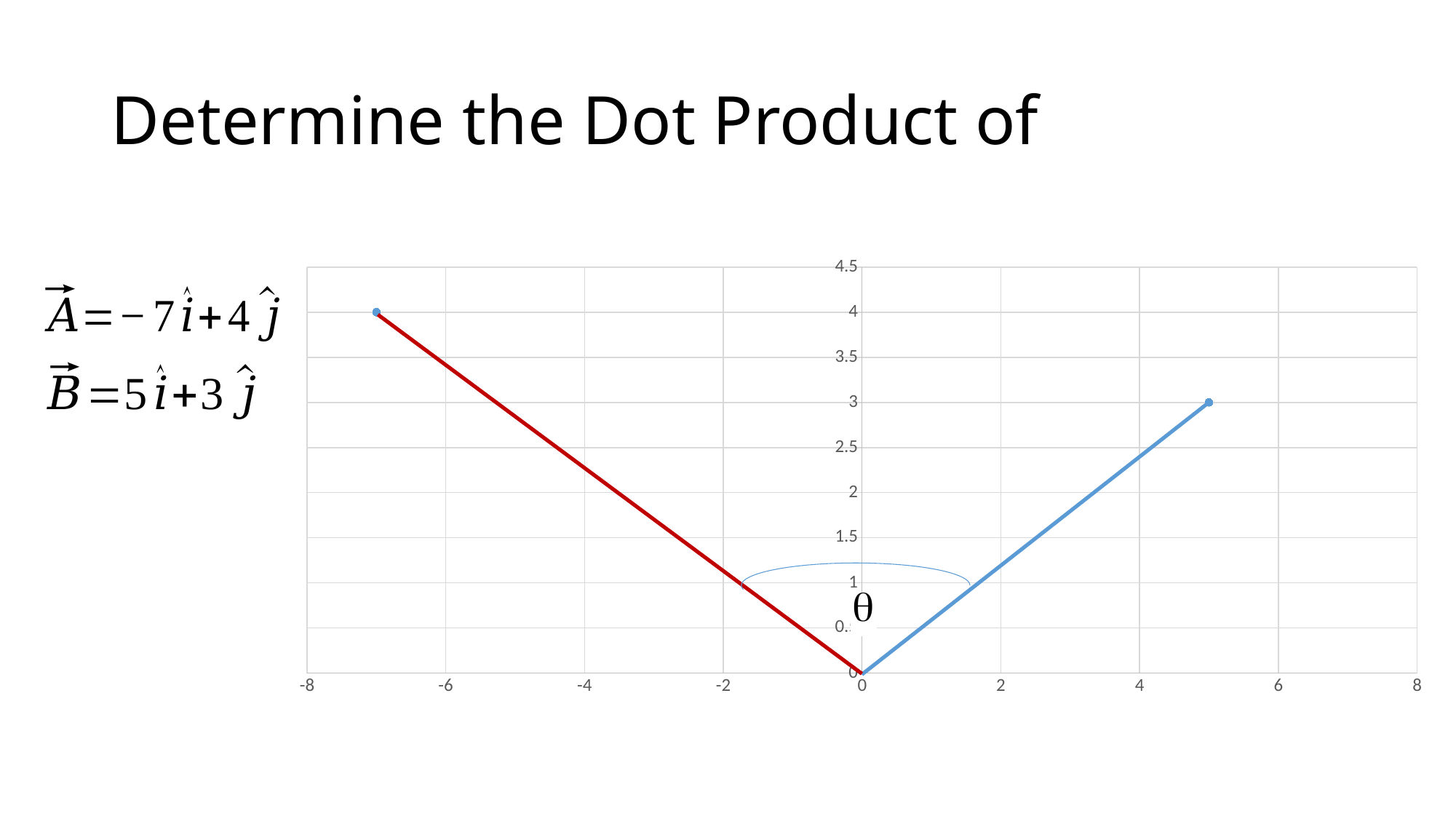
Which line reaches the higher y-value at its endpoint, the red or the blue? red What is the x-value at the endpoint of the blue line (vector B)? 5 What is the y-value at the endpoint of the blue line? 3 Does the chart show bars, lines, or pie slices? lines What is the y-value at the endpoint of the red line? 4 Is the endpoint y-value of the blue line greater or less than 2.5? greater What is the difference between the endpoint y-values of the red line and the blue line? 1 What symbol labels the angle between the two lines on the chart? θ How many vectors (lines) are plotted from the origin on the chart? 2 What is the highest value shown on the y axis? 4.5 What is the x-value at the endpoint of the red line (vector A)? -7 Is the endpoint x-value of the red line greater or less than -6? less